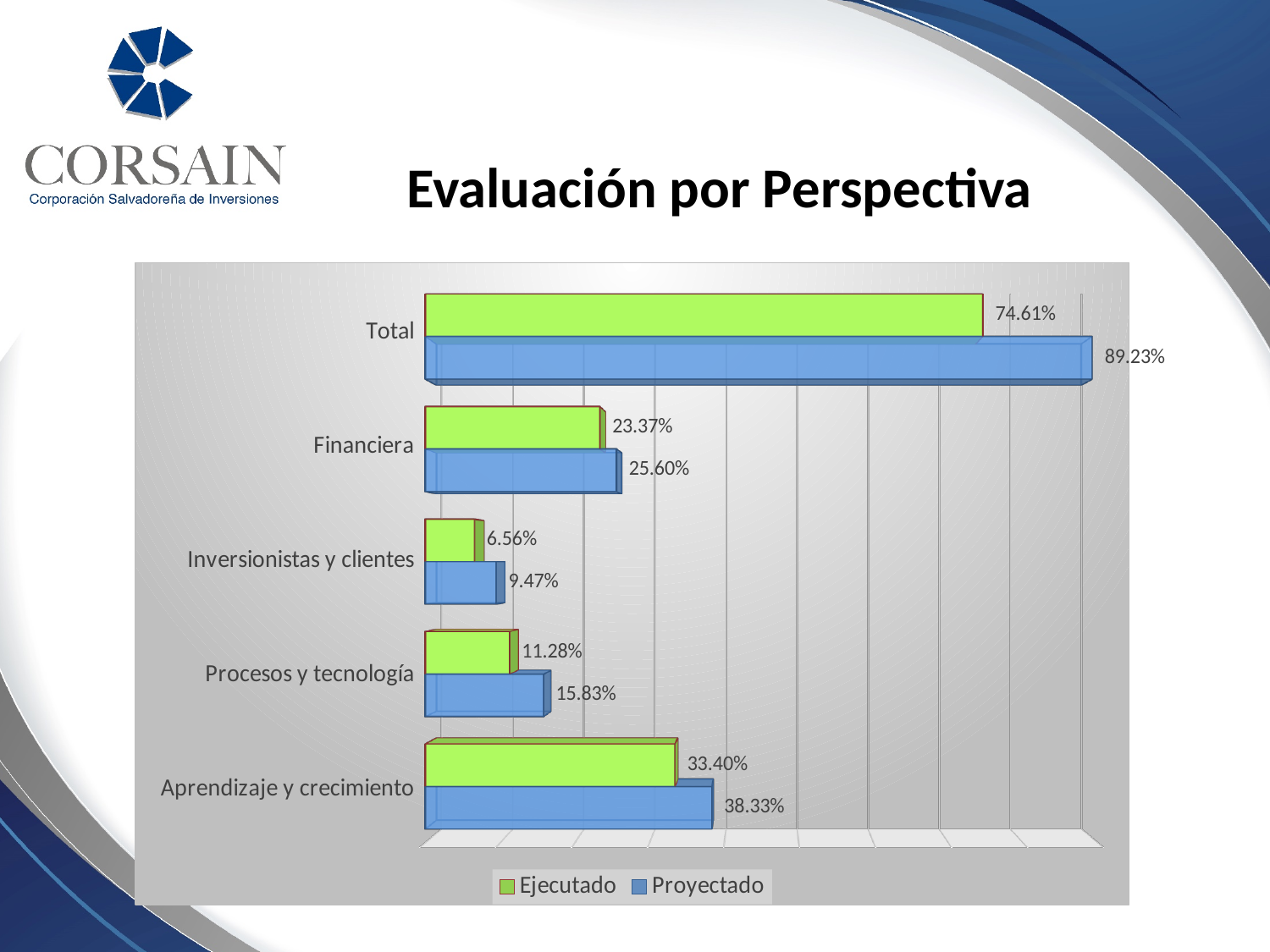
What kind of chart is shown on the slide? Bar chart What is the difference between the Proyectado and Ejecutado values for Total? 14.62% What is the Proyectado value for Total? 89.23% Which category has the lowest Ejecutado value? Inversionistas y clientes What is the title of the slide containing the chart? Evaluación por Perspectiva What is the Proyectado value for Aprendizaje y crecimiento? 38.33% How many categories are shown on the chart? 5 What is the Ejecutado value for Inversionistas y clientes? 6.56% What is the Ejecutado value for Financiera? 23.37% How many series does the legend list? 2 Excluding Total, which category has the highest Proyectado value? Aprendizaje y crecimiento Which is larger for Procesos y tecnología, the Ejecutado value or the Proyectado value? Proyectado